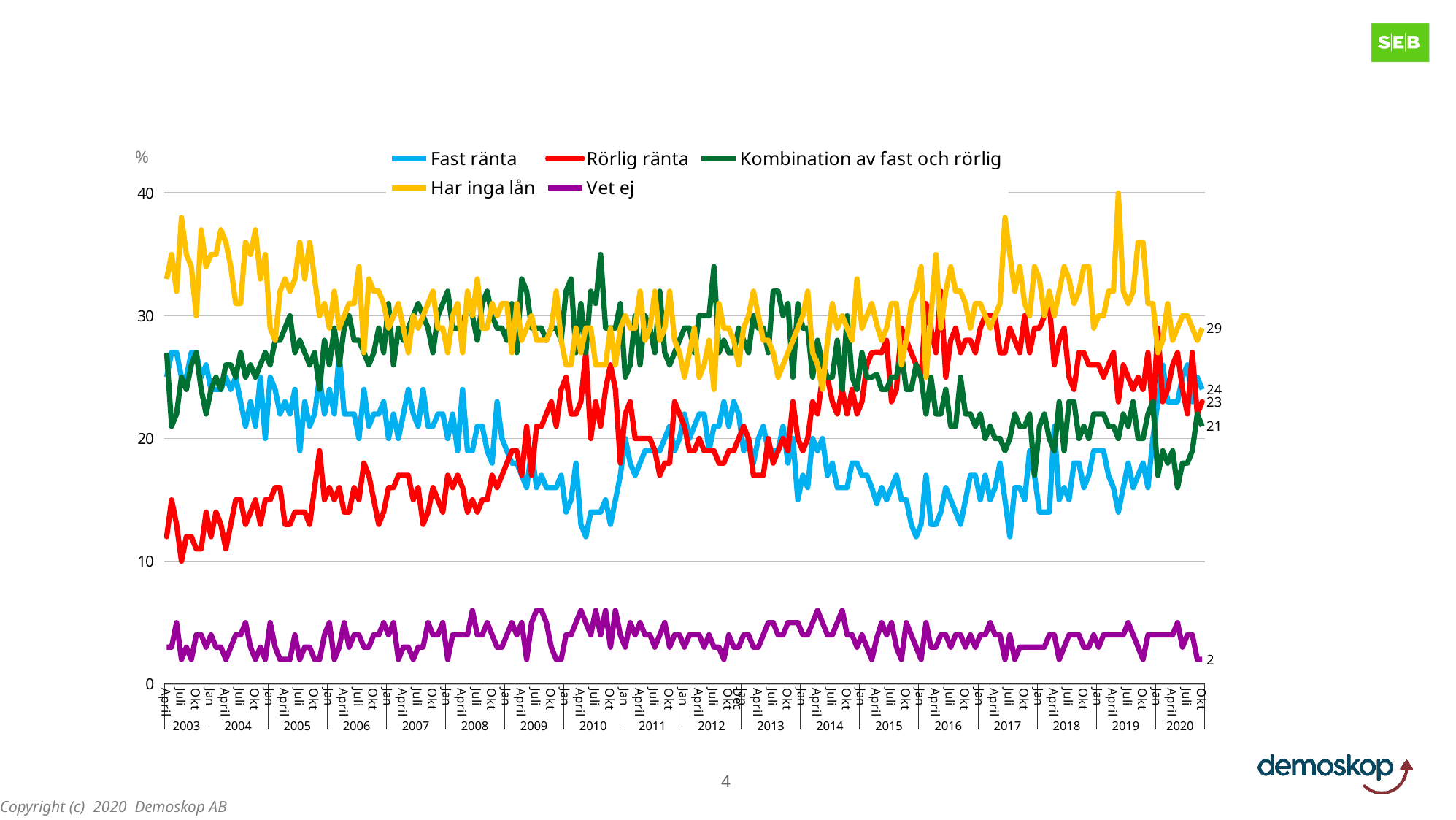
What is the final labelled value for Vet ej at the end of the series? 2 Does the Rörlig ränta series overall rise or fall from 2003 to 2020? rise What is the final labelled value for Fast ränta at the end of the series? 24 What is the difference between the final labelled values of Har inga lån and Fast ränta? 5 Which series has the lowest labelled value at the end of the series? Vet ej What is the final labelled value for Har inga lån at the end of the series? 29 What kind of chart is shown on the slide? line chart Is the value for Vet ej in 2010 greater or less than 10? less Which series has the highest labelled value at the end of the series? Har inga lån How many series does the legend list? 5 What is the final labelled value for Kombination av fast och rörlig at the end of the series? 21 What is the final labelled value for Rörlig ränta at the end of the series? 23